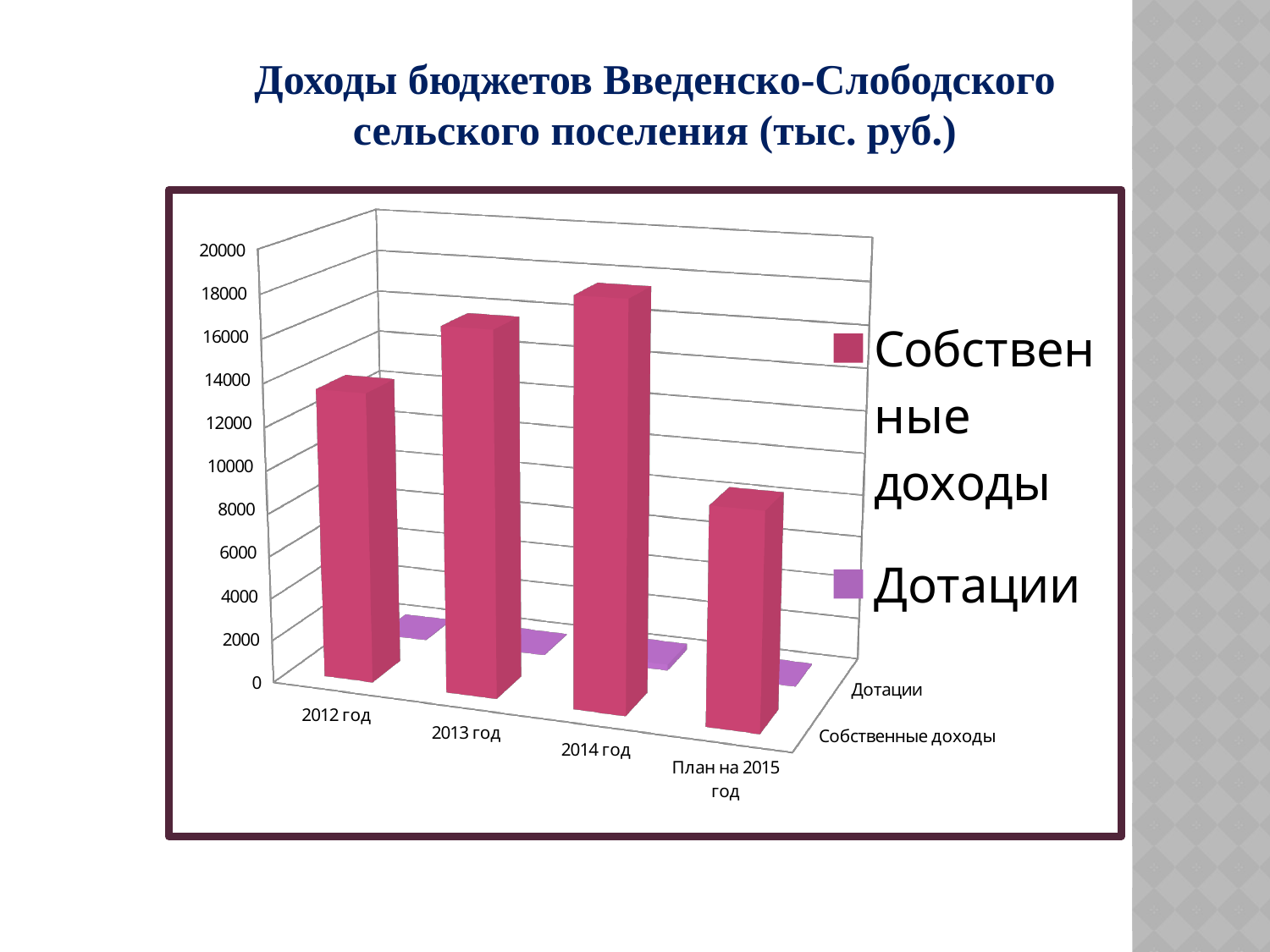
Is the value for Собственные доходы in 2014 год greater or less than 14000? greater What kind of chart is shown on the slide? bar chart Which category has the lowest value for Собственные доходы? План на 2015 год Is the value for Собственные доходы in План на 2015 год greater or less than 12000? less Is the value for Собственные доходы in 2012 год greater or less than 10000? greater Do the values for Собственные доходы rise or fall from 2012 год to 2014 год? rise Which year has the highest value for Собственные доходы? 2014 год What unit is given in the chart title? тыс. руб. How many categories are shown along the x axis? 4 Which series is shown in purple in the legend? Дотации Which is larger for Собственные доходы: 2012 год or 2013 год? 2013 год How many series does the legend list? 2